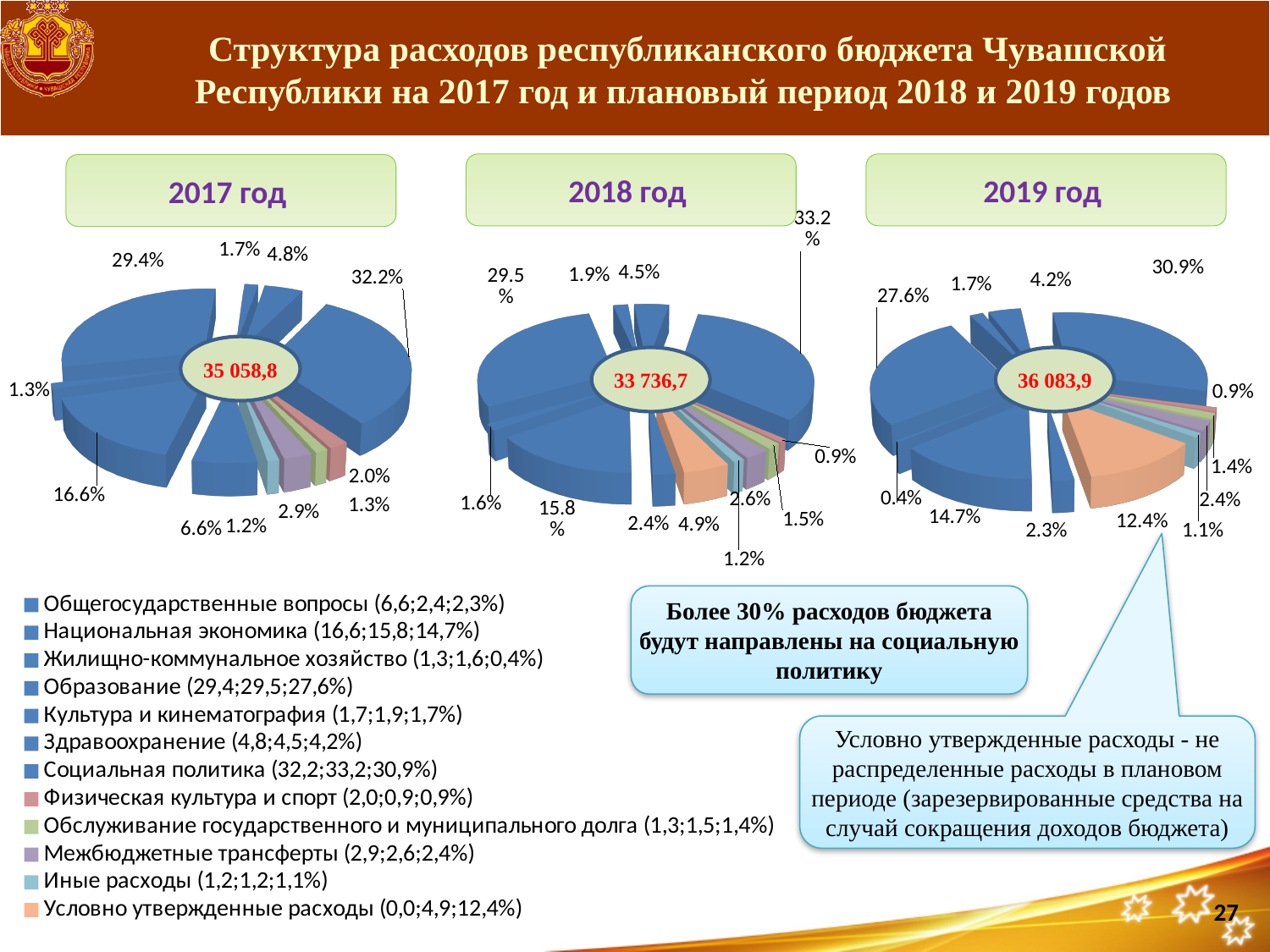
Does the share of Условно утвержденные расходы rise or fall from 2017 to 2019? Rise In the 2017 год pie chart, what share is shown for Социальная политика? 32.2% In the 2018 год pie chart, what is the difference between the shares of Социальная политика and Образование? 3.7% In the 2017 год pie chart, which is larger: the share of Здравоохранение or the share of Межбюджетные трансферты? Здравоохранение In the 2019 год pie chart, which category has the largest share? Социальная политика In the 2019 год pie chart, which category has the smallest share? Жилищно-коммунальное хозяйство How many expenditure categories does the legend list? 12 In the 2018 год pie chart, what share is shown for Национальная экономика? 15.8% What total value is printed in the centre of the 2019 год pie chart? 36 083,9 What total value is printed in the centre of the 2018 год pie chart? 33 736,7 In the 2019 год pie chart, what share is shown for Условно утвержденные расходы? 12.4% What kind of charts are shown on the slide? Pie charts